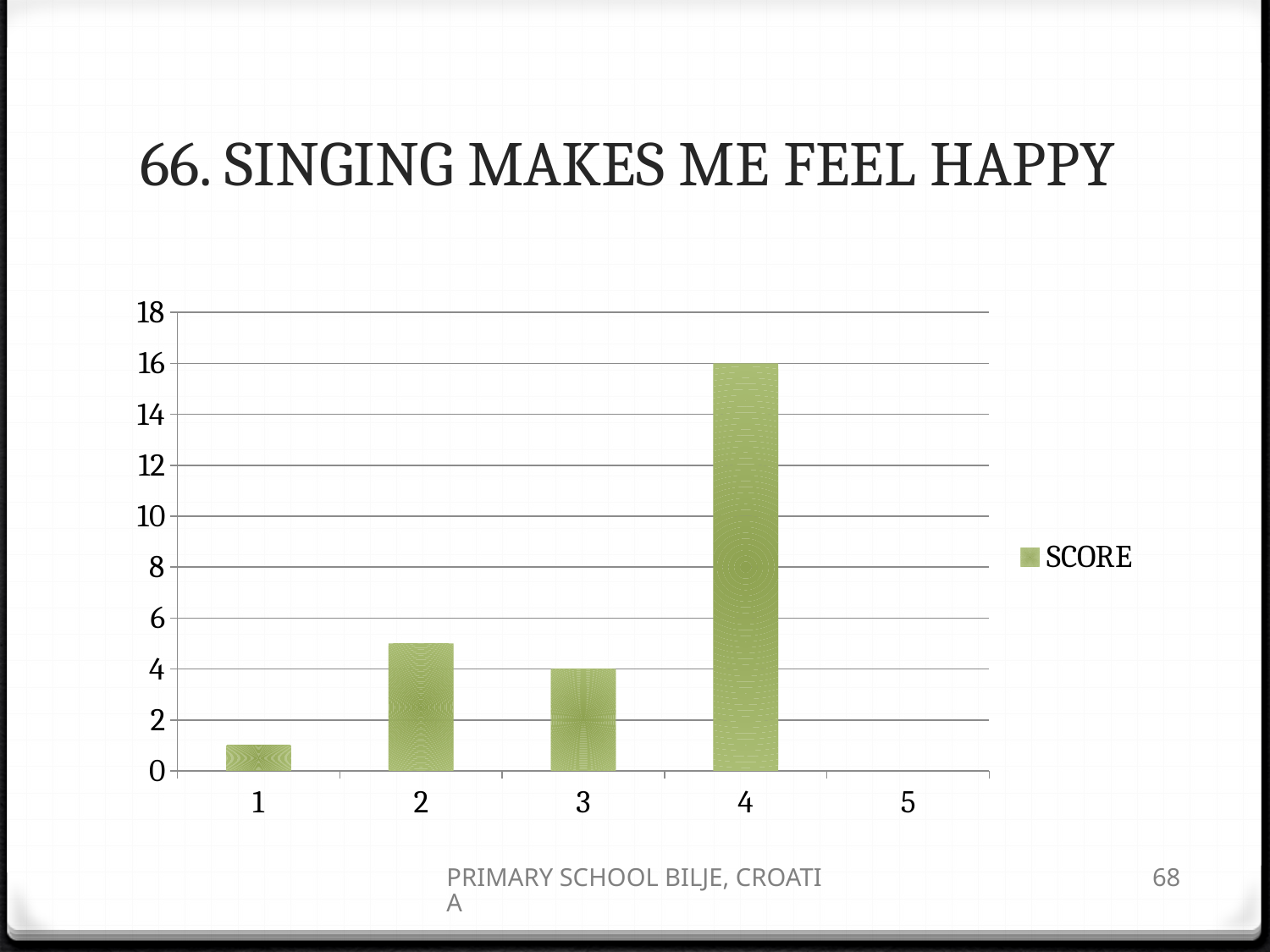
What is the value for category 5? 0 Which category has the highest value? 4 What is the difference between the values for category 4 and category 3? 12 What is the value for category 4? 16 How many categories are shown on the x axis? 5 Which has a larger value, category 2 or category 3? 2 Is the value for category 1 greater or less than 2? less Is the value for category 2 greater or less than 4? greater Which category has the lowest value? 5 How many series does the legend list? 1 What is the value for category 3? 4 What kind of chart is shown on the slide? bar chart